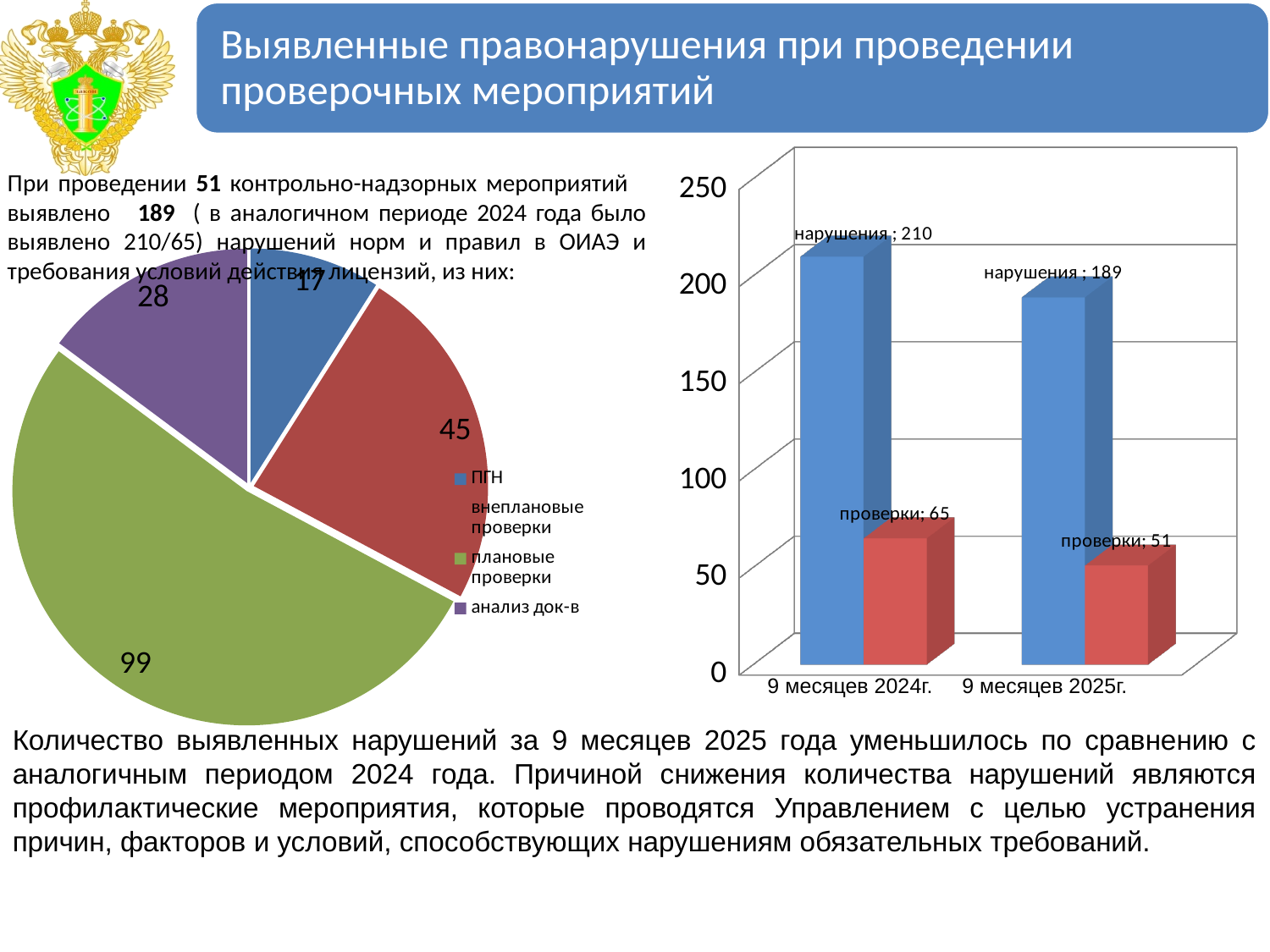
In the pie chart on the left, which category has the largest slice? плановые проверки In the pie chart on the left, which category has the smallest slice? ПГН In the pie chart on the left, how many categories does the legend list? 4 In the bar chart on the right, what is the value of нарушения for 9 месяцев 2025г.? 189 In the pie chart on the left, what is the difference between внеплановые проверки and анализ док-в? 17 In the bar chart on the right, what is the value of проверки for 9 месяцев 2024г.? 65 In the bar chart on the right, is the value of проверки for 9 месяцев 2025г. greater or less than 100? less In the bar chart on the right, by how much did нарушения decrease from 9 месяцев 2024г. to 9 месяцев 2025г.? 21 In the pie chart on the left, what is the value for плановые проверки? 99 What type of chart is shown on the right side of the slide? bar chart In the pie chart on the left, what is the value for ПГН? 17 In the pie chart on the left, what share of the total do плановые проверки represent? 52.4%